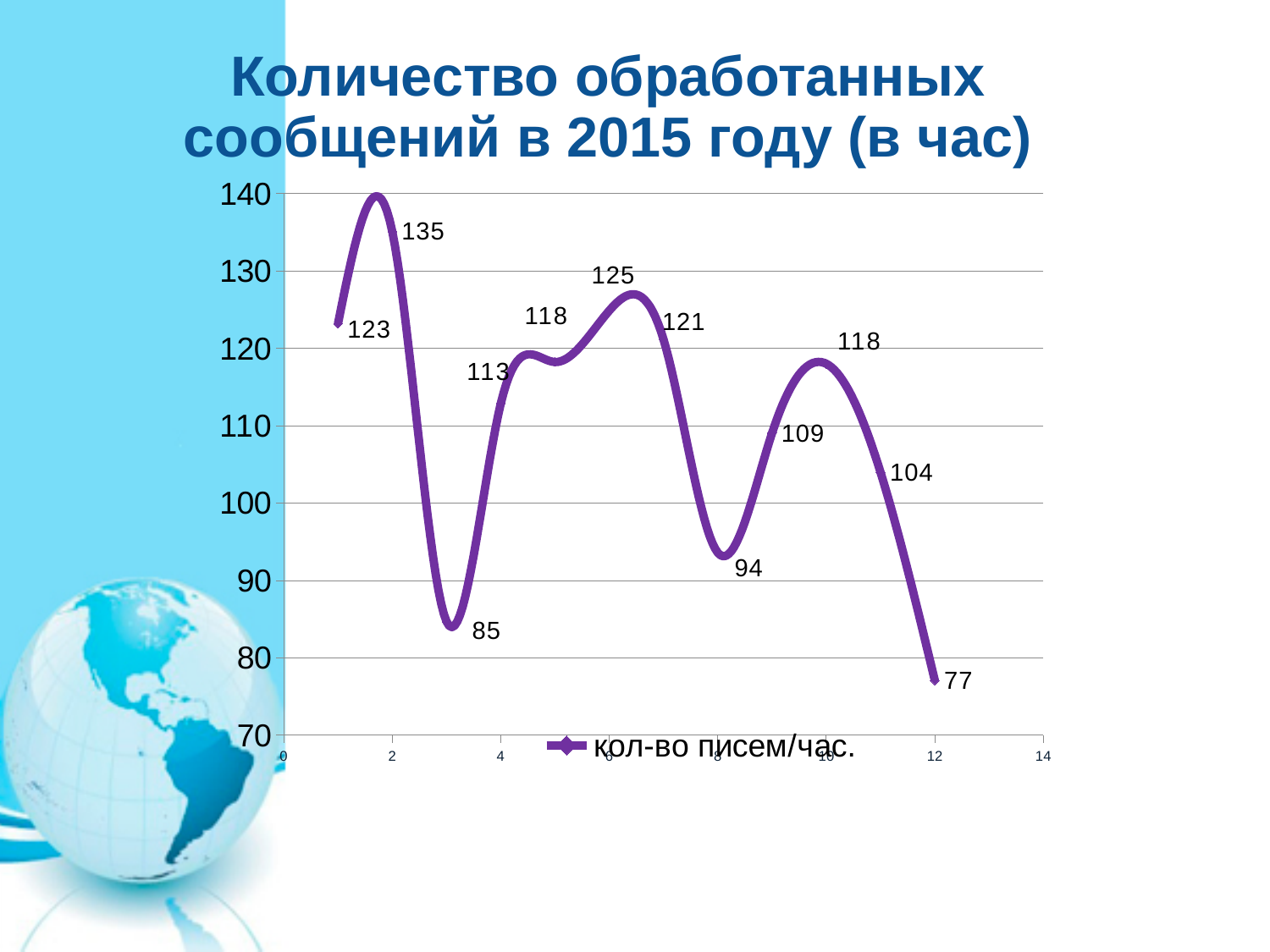
What is the value of the last data point (at x = 12)? 77 Does the line overall rise or fall from the first point to the last point? fall How many data points are plotted on the line? 12 What is the lowest value labelled on the line? 77 What is the title of the chart? Количество обработанных сообщений в 2015 году (в час) What is the highest value labelled on the line? 135 How many series does the legend list? 1 Which is larger: the value at x = 6 (125) or the value at x = 8 (94)? 125 What is the name of the series shown in the legend? кол-во писем/час. What type of chart is shown on the slide? line chart What is the value of the first data point (at x = 1)? 123 What is the difference between the highest value (135) and the lowest value (77)? 58